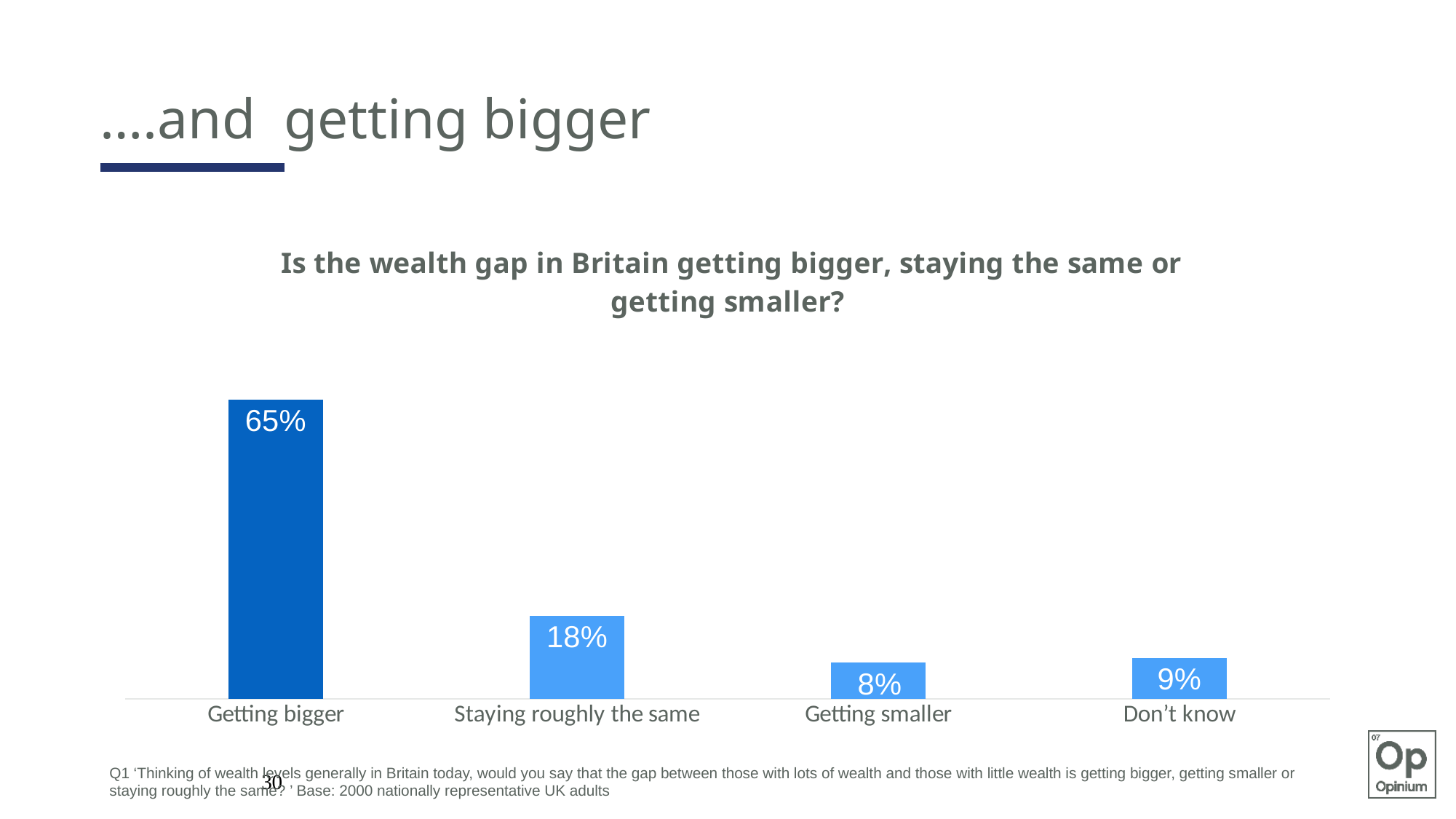
Which is larger: 'Staying roughly the same' or 'Don't know'? Staying roughly the same Which response has the lowest value? Getting smaller What kind of chart is shown on the slide? Bar chart How many response categories are shown in the chart? 4 What is the difference between 'Don't know' and 'Getting smaller'? 1 percentage point What is the title of the chart? Is the wealth gap in Britain getting bigger, staying the same or getting smaller? What percentage said the wealth gap is getting smaller? 8% Which response has the highest value? Getting bigger What value is shown for 'Don't know'? 9% What percentage of respondents said the wealth gap is getting bigger? 65% What is the difference between 'Getting bigger' and 'Staying roughly the same'? 47 percentage points What value is shown for 'Staying roughly the same'? 18%